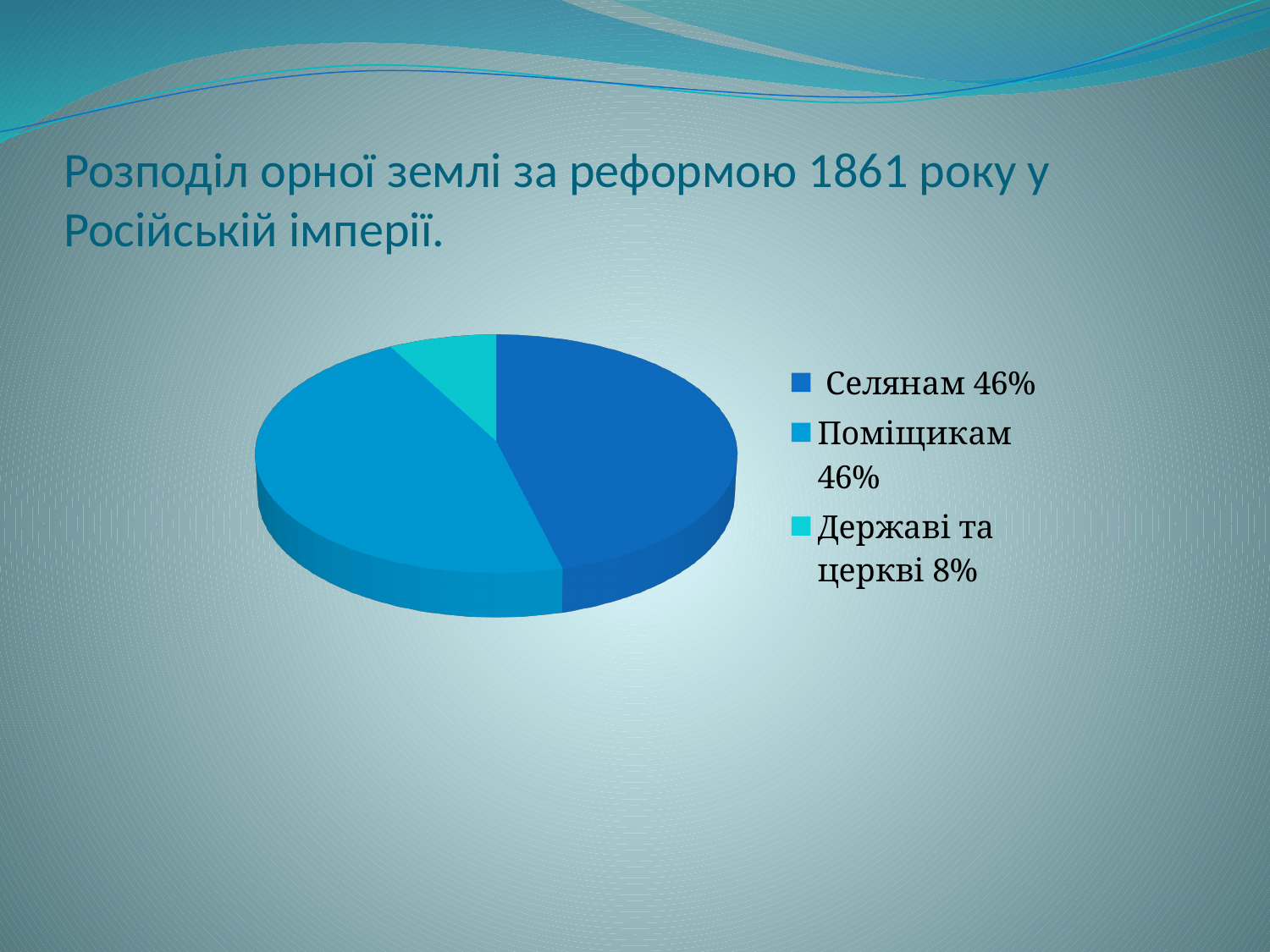
What share of the arable land went to Державі та церкві according to the chart? 8% How many slices does the pie chart have? 3 Which two categories have equal shares in the pie chart? Селянам and Поміщикам Which category has the smallest slice of the pie? Державі та церкві How many entries does the legend list? 3 What share of the arable land went to Поміщикам according to the chart? 46% Which legend entry is shown in the lightest (turquoise) colour? Державі та церкві 8% What is the difference in percentage points between the share for Поміщикам and the share for Державі та церкві? 38 What kind of chart is shown on the slide? pie chart Which is larger: the share for Селянам or the share for Державі та церкві? Селянам What is the title of the slide containing the pie chart? Розподіл орної землі за реформою 1861 року у Російській імперії. What share of the arable land went to Селянам according to the chart? 46%